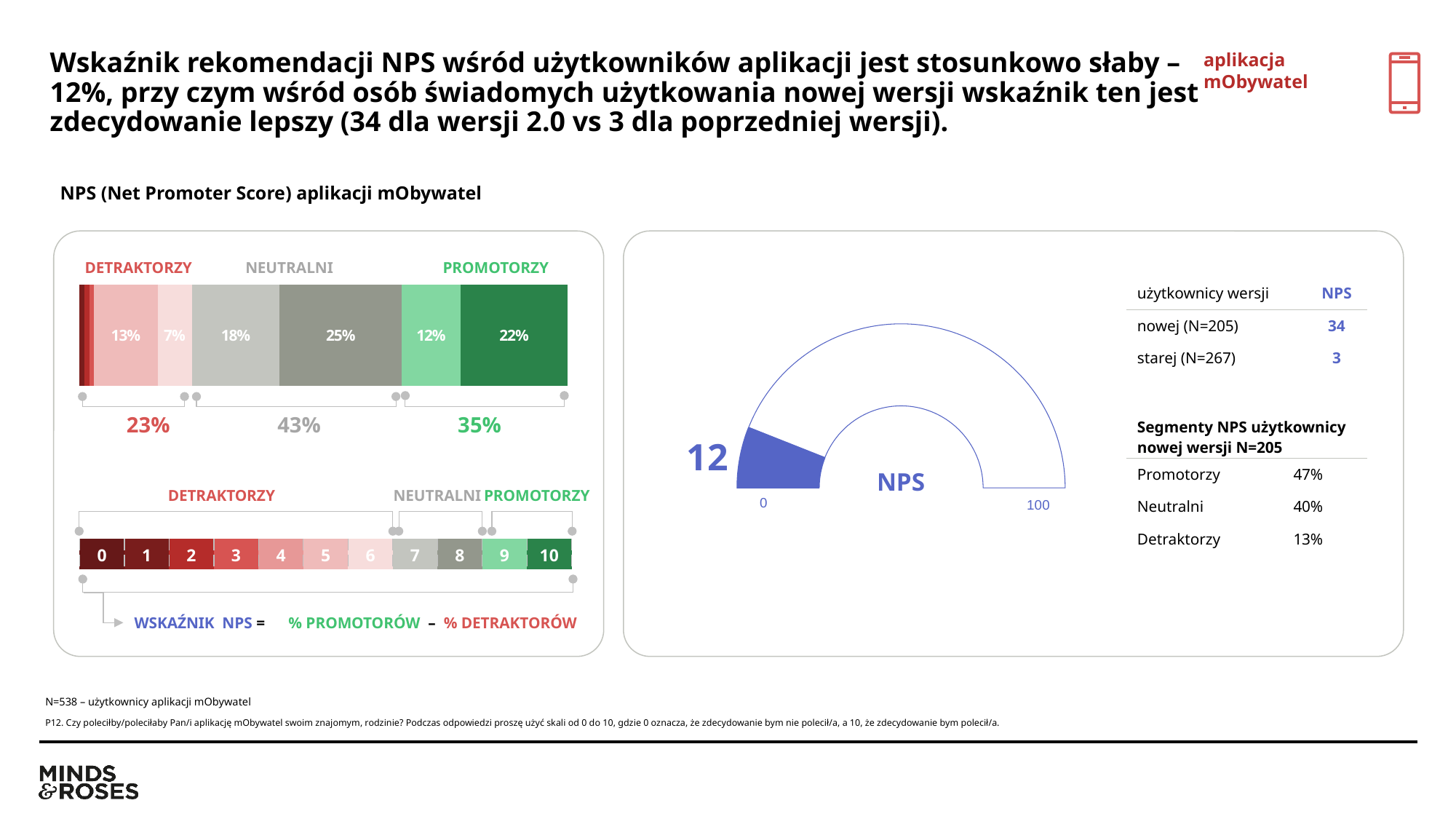
On the stacked bar chart on the left, what is the total share of Detraktorzy? 23% On the stacked bar chart on the left, what is the total share of Neutralni? 43% On the stacked bar chart on the left, which group has a larger total share, Neutralni or Promotorzy? Neutralni On the stacked bar chart on the left, what is the total share of Promotorzy? 35% What kind of chart is the chart on the left showing Detraktorzy, Neutralni and Promotorzy? Stacked bar chart On the gauge chart on the right, is the NPS value greater or less than 50? less On the gauge chart on the right, what NPS value is shown? 12 On the gauge chart on the right, what are the minimum and maximum values shown on the scale? 0 and 100 On the stacked bar chart on the left, what is the difference between the Promotorzy total and the Detraktorzy total? 12 percentage points On the stacked bar chart on the left, what is the largest percentage labelled on any single segment? 25% On the stacked bar chart on the left, what is the smallest percentage labelled on any single segment? 7% In the table next to the gauge chart, what is the NPS for users of the new version (N=205)? 34